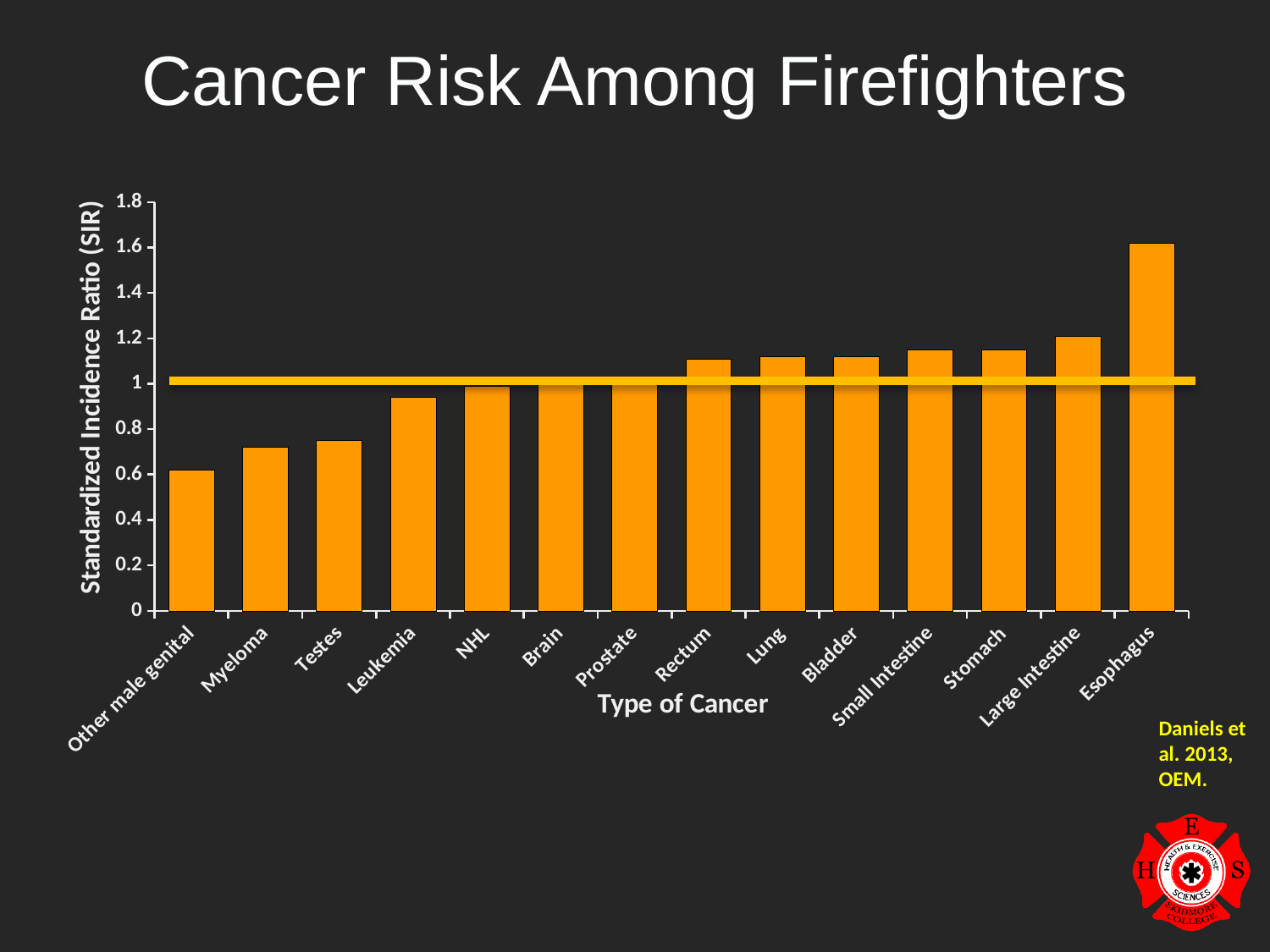
What is the label of the y axis? Standardized Incidence Ratio (SIR) Is the SIR value for Other male genital greater or less than 0.8? less Is the SIR value for Large Intestine greater or less than 1? greater How many types of cancer are plotted on the x axis? 14 Which type of cancer has the highest Standardized Incidence Ratio? Esophagus Is the SIR value for Myeloma greater or less than 1? less Which type of cancer has the lowest Standardized Incidence Ratio? Other male genital Which has a larger SIR, Testes or Large Intestine? Large Intestine Which has a larger SIR, Esophagus or Lung? Esophagus What kind of chart is shown on the slide? bar chart Do the bar values generally rise or fall from left to right along the x axis? rise